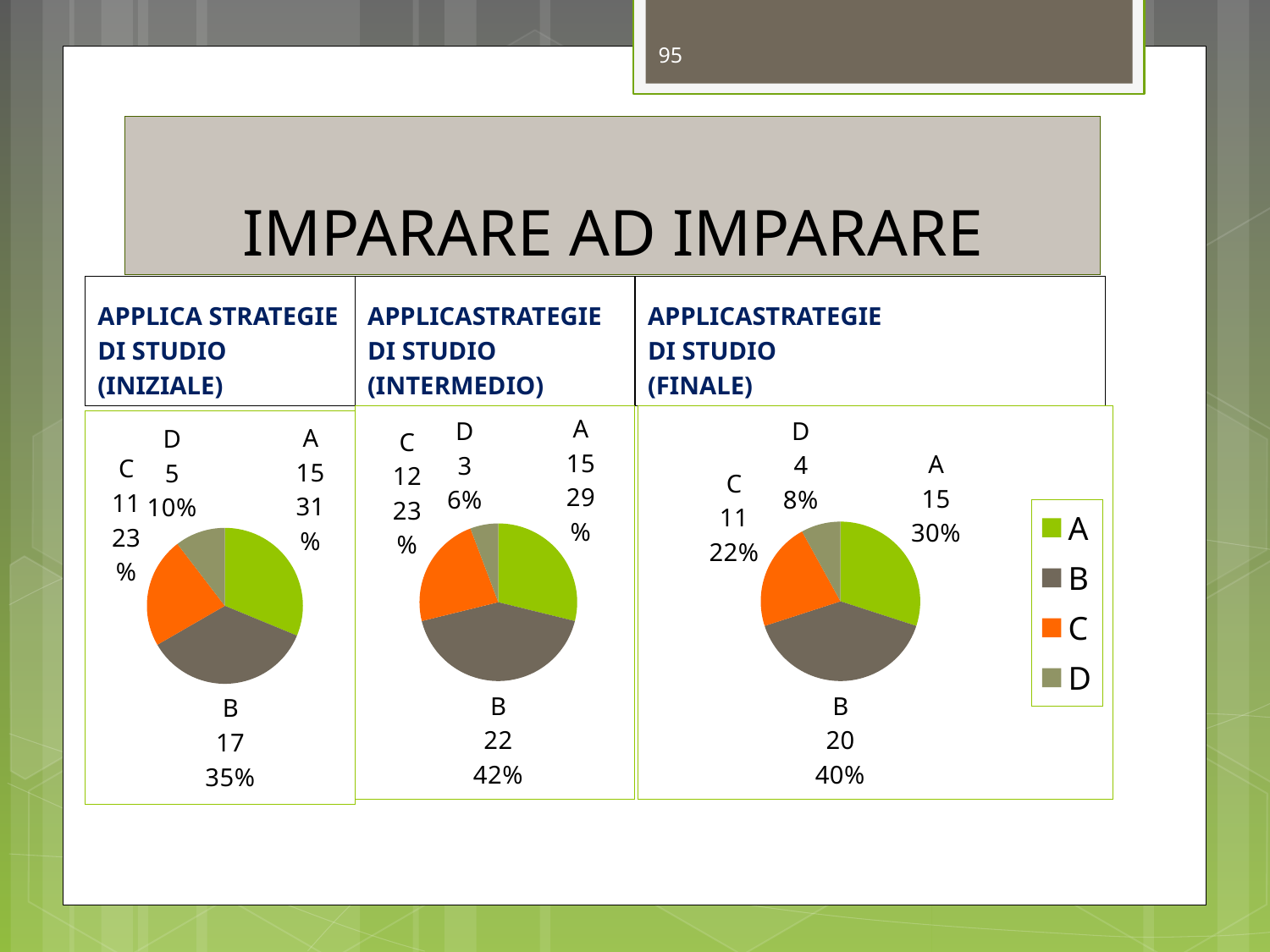
In the APPLICASTRATEGIE DI STUDIO (FINALE) chart, which category has the largest slice? B In the APPLICASTRATEGIE DI STUDIO (FINALE) chart, what is the value for D? 4 What type of chart is used for APPLICA STRATEGIE DI STUDIO (INIZIALE)? Pie chart In the APPLICASTRATEGIE DI STUDIO (FINALE) chart, which is larger, the value for A or the value for C? A In the APPLICA STRATEGIE DI STUDIO (INIZIALE) chart, which category has the smallest slice? D In the APPLICA STRATEGIE DI STUDIO (INIZIALE) chart, what is the value for B? 17 In the APPLICA STRATEGIE DI STUDIO (INIZIALE) chart, what percentage share does C have? 23% How many entries does the legend on the right of the slide list? 4 According to the legend, which colour represents category C? Orange How many slices does the APPLICASTRATEGIE DI STUDIO (INTERMEDIO) pie chart have? 4 In the APPLICASTRATEGIE DI STUDIO (INTERMEDIO) chart, what is the difference between the values for B and A? 7 In the APPLICASTRATEGIE DI STUDIO (INTERMEDIO) chart, what percentage share does B have? 42%